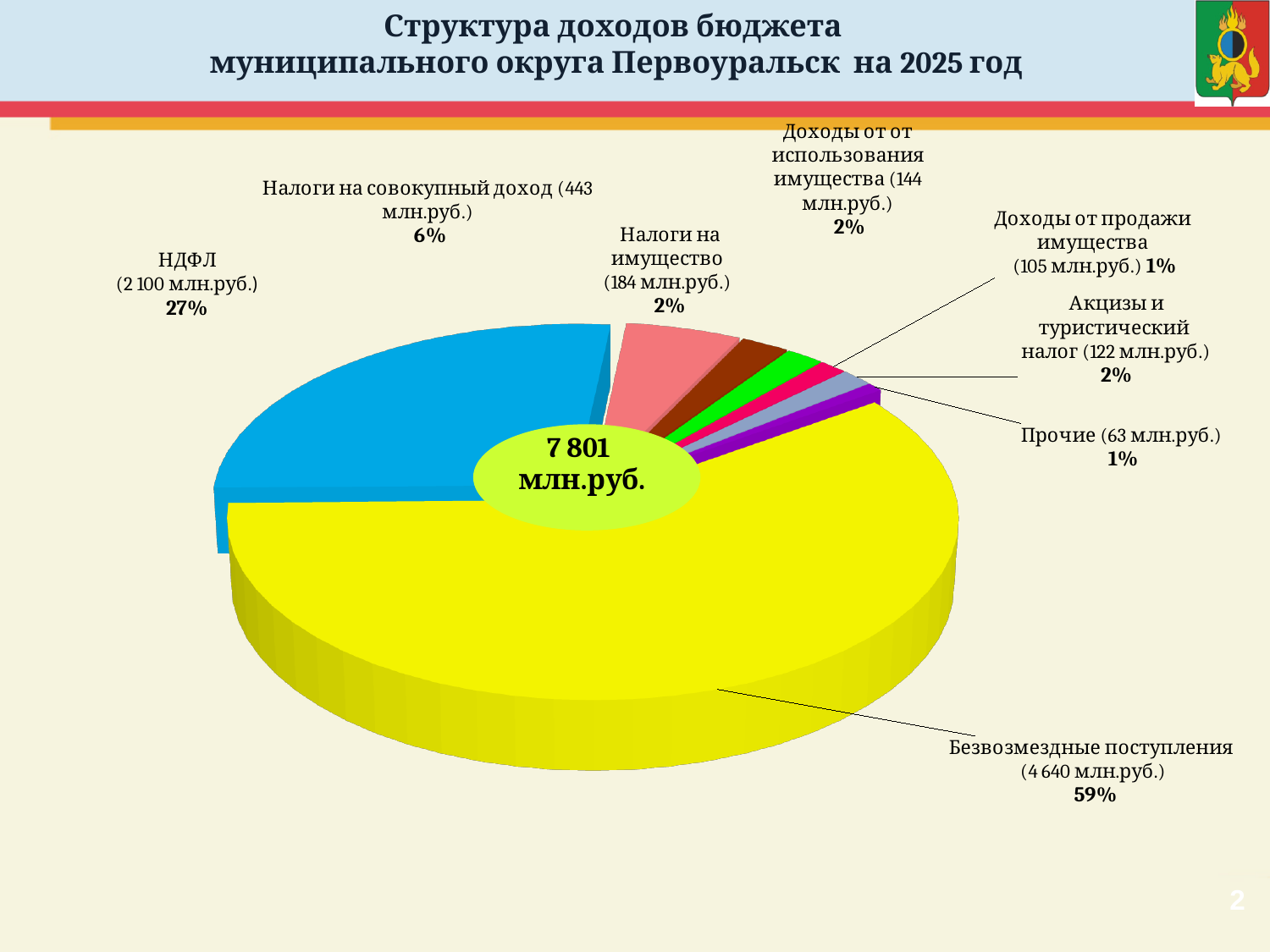
What is the difference between Безвозмездные поступления and НДФЛ? 2 540 млн.руб. Which is larger: Доходы от использования имущества or Доходы от продажи имущества? Доходы от использования имущества What share of the pie does Налоги на имущество represent? 2% Which category has the largest share of the pie? Безвозмездные поступления What is the value for Акцизы и туристический налог? 122 млн.руб. What is the value for Безвозмездные поступления? 4 640 млн.руб. What is the value for НДФЛ? 2 100 млн.руб. What kind of chart is shown on the slide? pie chart What share of the pie does НДФЛ represent? 27% How many categories are shown in the pie chart? 8 Which category has the smallest value? Прочие What is the value for Налоги на совокупный доход? 443 млн.руб.